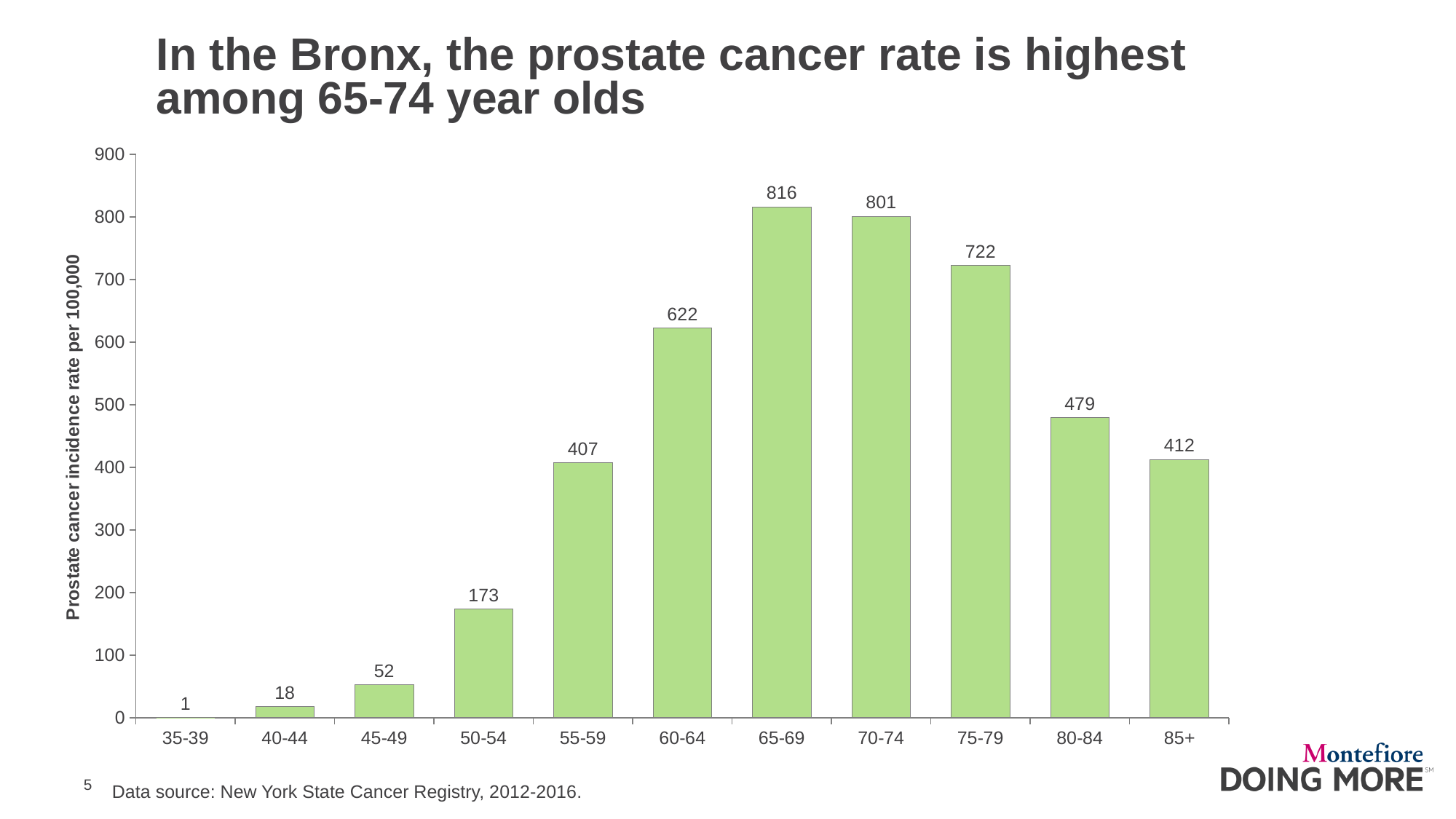
What kind of chart is shown on the slide? Bar chart What is the difference in incidence rate between the 60-64 and 50-54 age groups? 449 How many age groups are shown on the x axis? 11 What is the prostate cancer incidence rate per 100,000 for the 65-69 age group? 816 Which age group has the highest prostate cancer incidence rate? 65-69 What is the prostate cancer incidence rate per 100,000 for the 85+ age group? 412 What is the prostate cancer incidence rate per 100,000 for the 55-59 age group? 407 Which age group has a higher incidence rate, 80-84 or 85+? 80-84 Which age group has the lowest prostate cancer incidence rate? 35-39 Is the incidence rate for the 75-79 age group greater or less than 700? greater What is the difference in incidence rate between the 70-74 and 75-79 age groups? 79 What is the label of the vertical axis? Prostate cancer incidence rate per 100,000